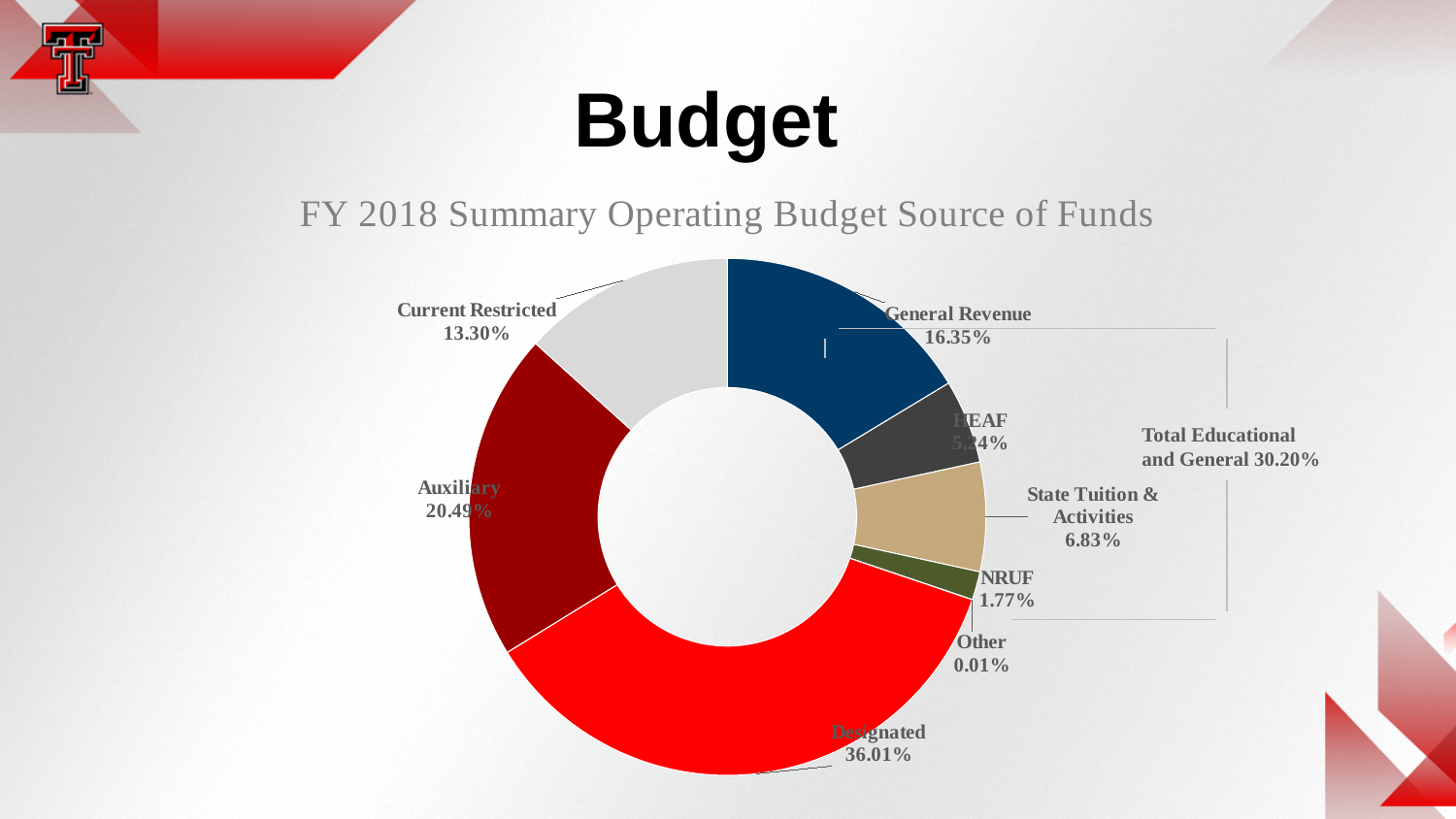
What percentage of the budget source of funds is State Tuition & Activities? 6.83% What is the title of the chart? FY 2018 Summary Operating Budget Source of Funds What is the difference between the Designated share and the Auxiliary share? 15.52% What percentage of the budget source of funds is Current Restricted? 13.30% What percentage of the budget source of funds is General Revenue? 16.35% What percentage of the budget source of funds is Designated? 36.01% How many slices does the chart have? 8 Which source of funds has the smallest share? Other What percentage of the budget source of funds is Auxiliary? 20.49% What percentage of the budget source of funds is NRUF? 1.77% Which source of funds has the largest share? Designated What kind of chart is shown on the slide? Pie (doughnut) chart